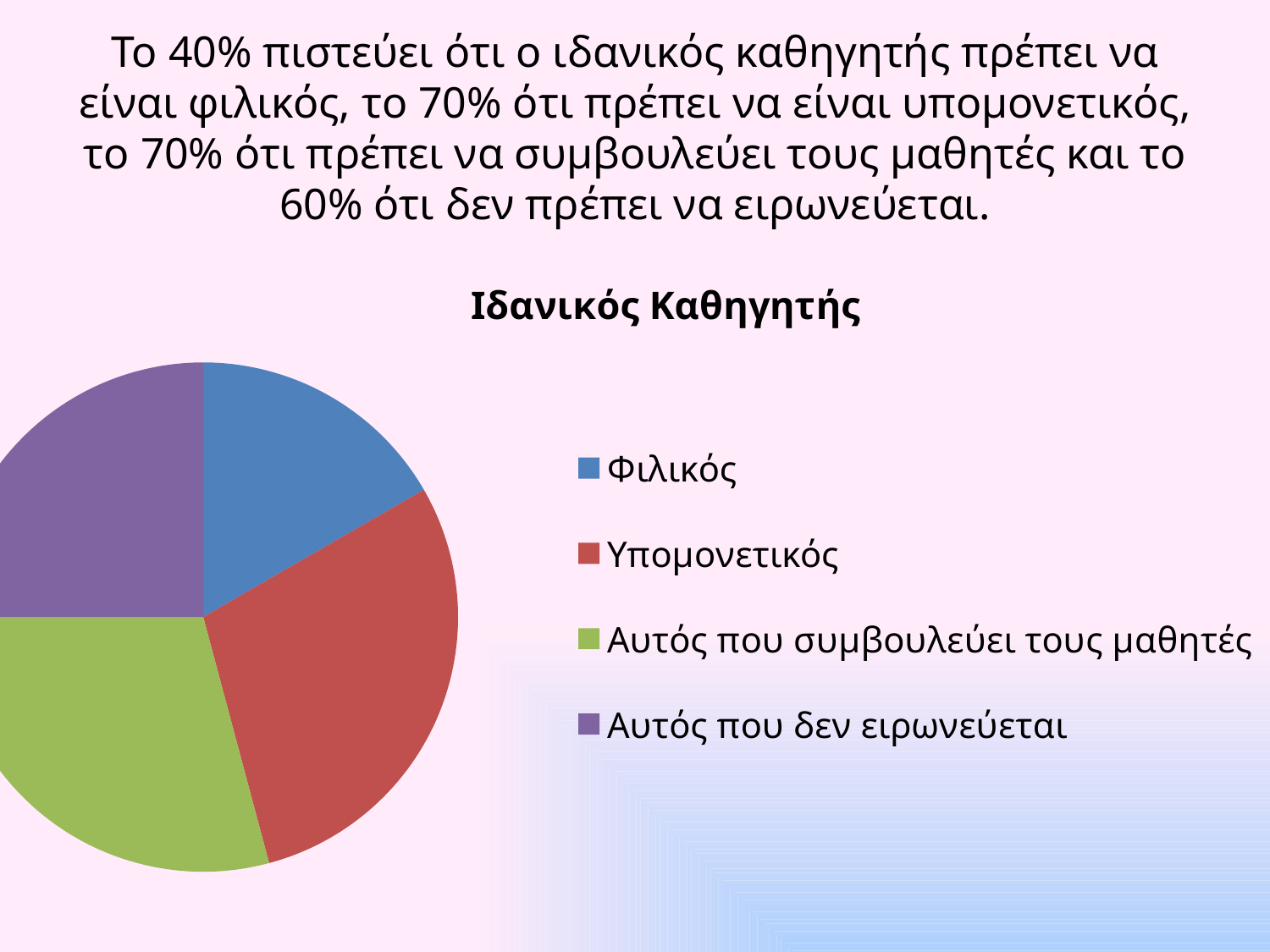
How many entries does the legend of the pie chart list? 4 Which slice is larger, Αυτός που συμβουλεύει τους μαθητές or Φιλικός? Αυτός που συμβουλεύει τους μαθητές Which slice of the pie chart is the smallest? Φιλικός Which slice is larger, Φιλικός or Υπομονετικός? Υπομονετικός How many slices does the pie chart have? 4 Which colour represents Υπομονετικός in the pie chart? red Which slice is larger, Φιλικός or Αυτός που δεν ειρωνεύεται? Αυτός που δεν ειρωνεύεται What is the title of the pie chart? Ιδανικός Καθηγητής What kind of chart is shown on the slide? pie chart